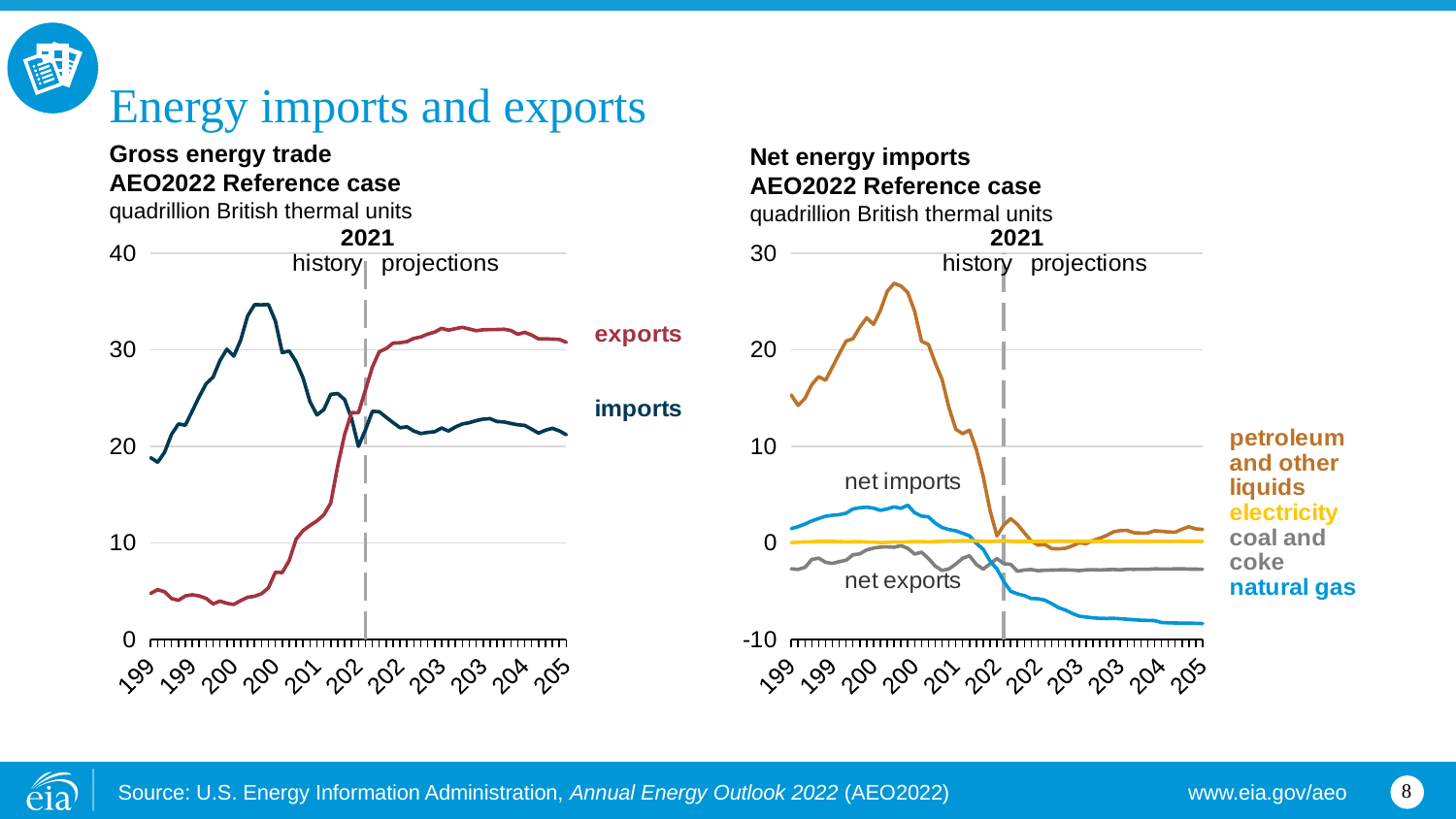
On the 'Gross energy trade' chart, is the peak value for imports during the history period greater or less than 30? greater On the 'Net energy imports' chart, is the value for natural gas at the end of the projection period greater or less than 0? less How many series are listed in the legend of the 'Net energy imports' chart on the right? 4 How many series are shown on the 'Gross energy trade' chart on the left? 2 What kind of chart is the 'Gross energy trade' chart on the left? line chart On the 'Net energy imports' chart, is the peak value for petroleum and other liquids greater or less than 20? greater What year separates history from projections on both charts? 2021 On the 'Gross energy trade' chart, which series is higher at the end of the projection period, exports or imports? exports On the 'Net energy imports' chart, do the values for natural gas rise or fall over the projection period? fall What unit is used on the y axis of the 'Net energy imports' chart? quadrillion British thermal units